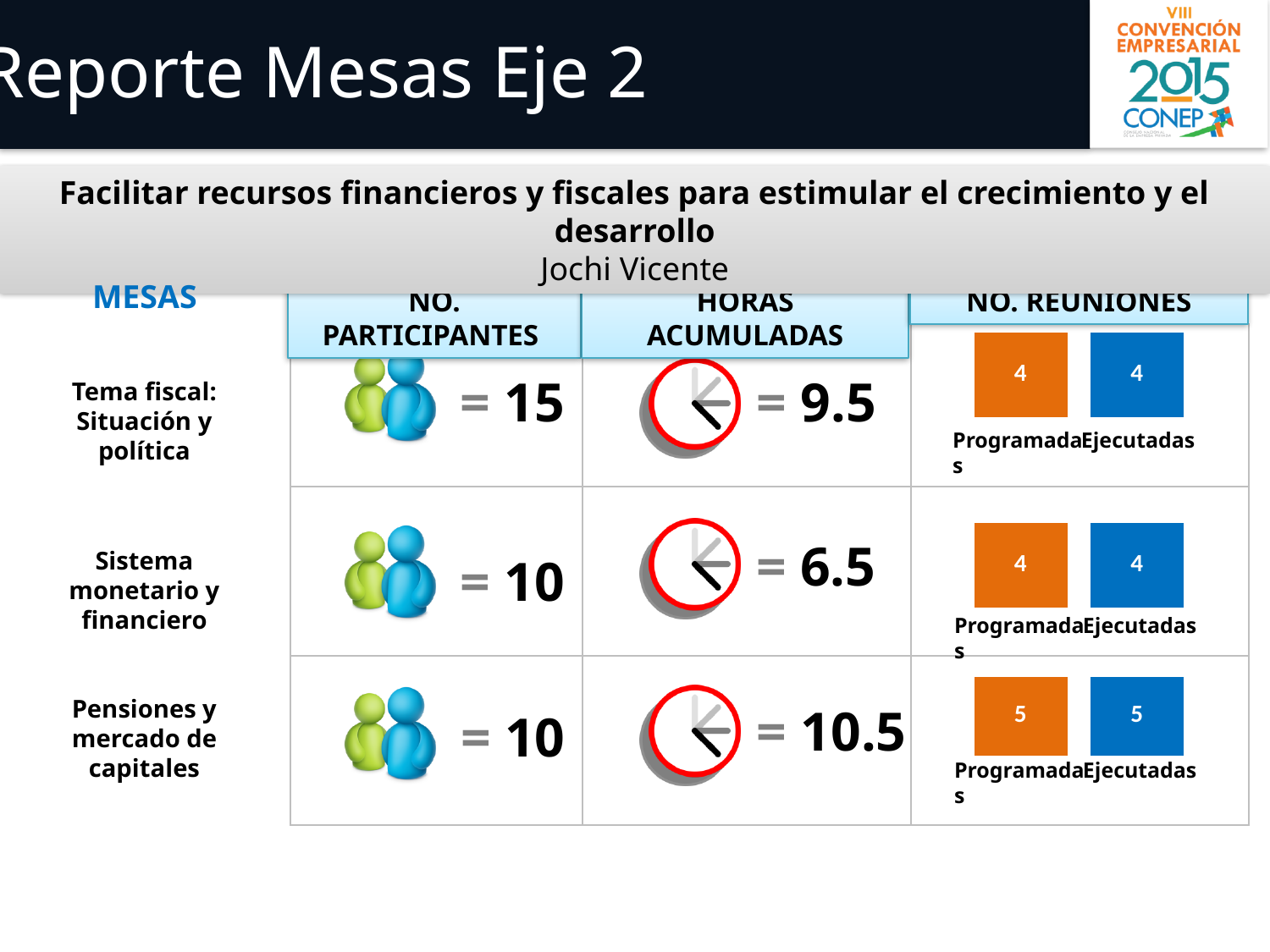
In the NO. REUNIONES chart for the Sistema monetario y financiero row, what is the value of the Programadas bar? 4 Across the three NO. REUNIONES charts, which row has the highest Programadas value? Pensiones y mercado de capitales In the NO. REUNIONES chart for the Pensiones y mercado de capitales row, what is the value of the Ejecutadas bar? 5 In the NO. REUNIONES chart for the Pensiones y mercado de capitales row, what is the value of the Programadas bar? 5 In the NO. REUNIONES chart for the Pensiones y mercado de capitales row, what is the difference between the Programadas and Ejecutadas bars? 0 In the NO. REUNIONES chart for the Tema fiscal: Situación y política row, what colour is the Programadas bar? Orange In the NO. REUNIONES chart for the Tema fiscal: Situación y política row, what is the value of the Ejecutadas bar? 4 In the NO. REUNIONES chart for the Sistema monetario y financiero row, what colour is the Ejecutadas bar? Blue In the NO. REUNIONES chart for the Tema fiscal: Situación y política row, what is the value of the Programadas bar? 4 How many bars does the NO. REUNIONES chart for the Sistema monetario y financiero row have? 2 In the NO. REUNIONES chart for the Sistema monetario y financiero row, what is the total of the Programadas and Ejecutadas bars? 8 What kind of chart is used in the NO. REUNIONES column for each row? Bar chart